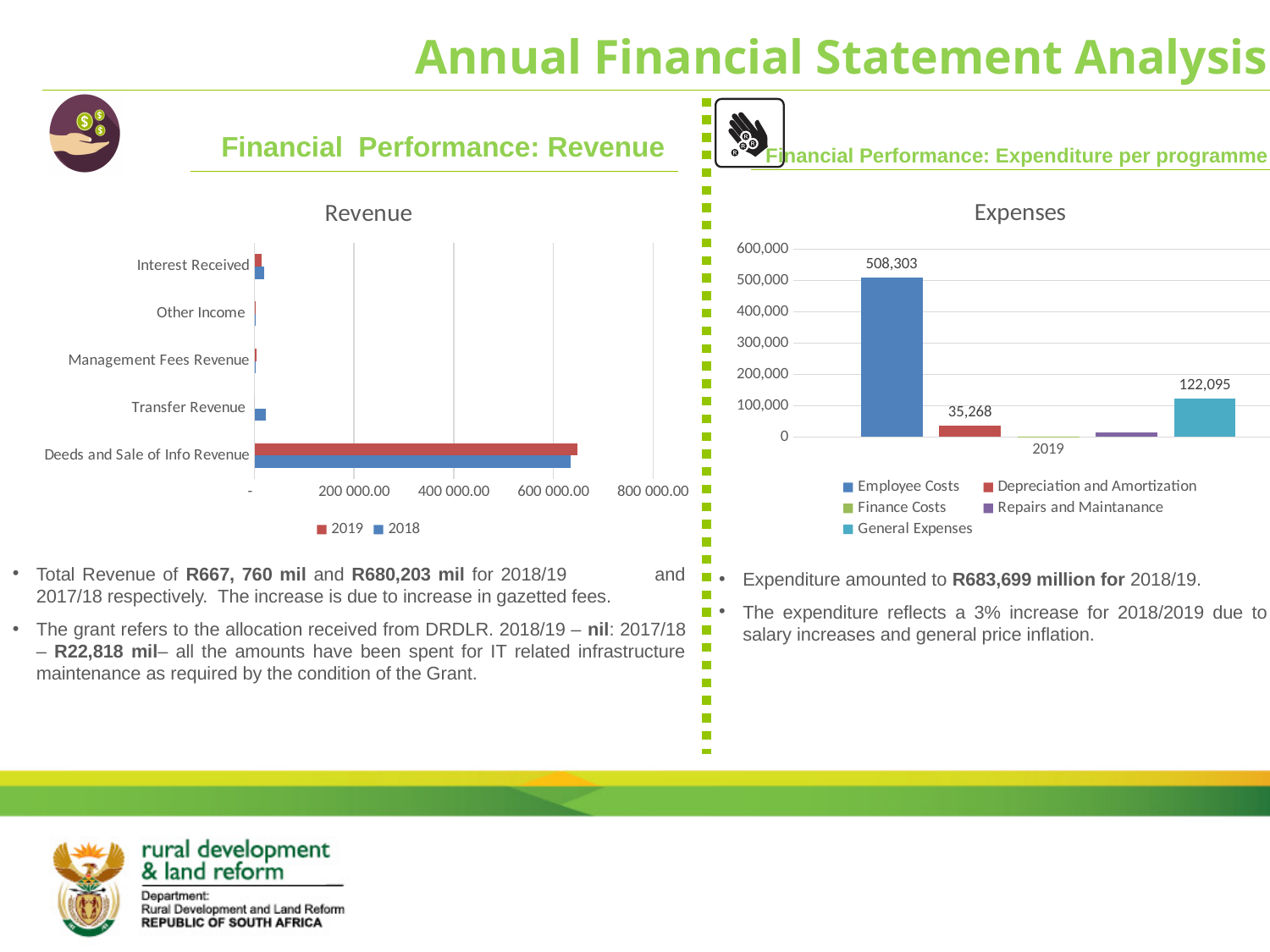
In the Revenue chart, is the 2018 value for Transfer Revenue greater or less than 200 000.00? less In the Expenses chart, what is the value for Depreciation and Amortization? 35,268 In the Expenses chart, what is the value for General Expenses? 122,095 What kind of chart is the Revenue chart on the left? Bar chart In the Revenue chart, is the 2019 value for Deeds and Sale of Info Revenue greater or less than 600 000.00? greater In the Expenses chart, what is the difference between Employee Costs and Depreciation and Amortization? 473,035 In the Revenue chart, how many series does the legend list? 2 In the Expenses chart, what is the value for Employee Costs? 508,303 In the Expenses chart, how many series does the legend list? 5 In the Revenue chart, which category has the highest revenue? Deeds and Sale of Info Revenue In the Expenses chart, is the value for Repairs and Maintanance greater or less than 100,000? less In the Revenue chart, how many revenue categories are listed on the vertical axis? 5